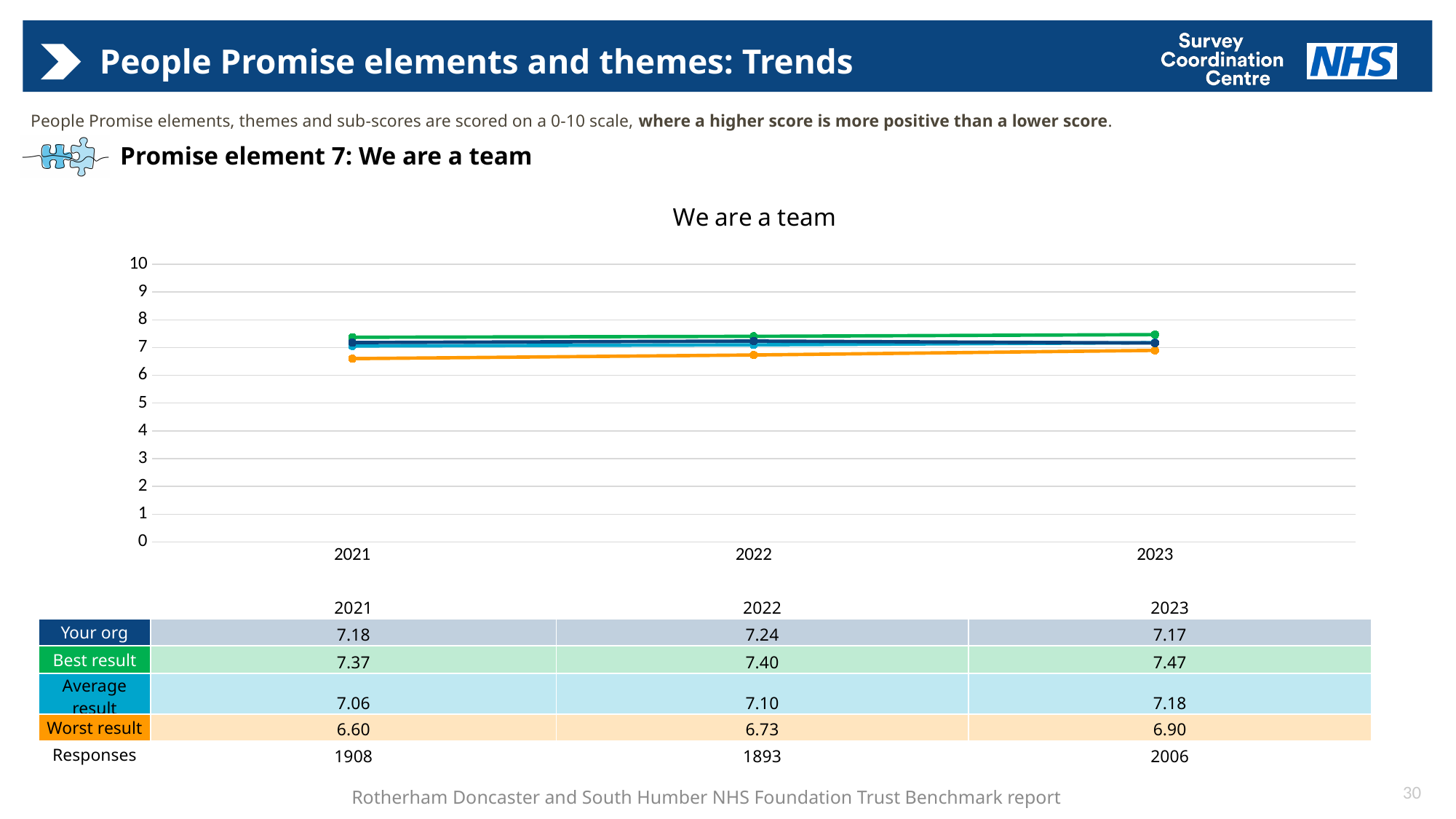
What is the Average result score for 2022? 7.10 In which year is the Your org score highest? 2022 What is the title of the chart? We are a team In which year is the Worst result score lowest? 2021 How many years are plotted on the x axis? 3 What is the Your org score for 2022? 7.24 Does the Worst result score rise or fall from 2021 to 2023? rise What kind of chart is shown on the slide? line chart What is the Best result score for 2023? 7.47 Which is larger in 2021, the Your org score or the Average result score? Your org What is the difference between the Best result and Worst result scores in 2023? 0.57 What is the Worst result score for 2021? 6.60